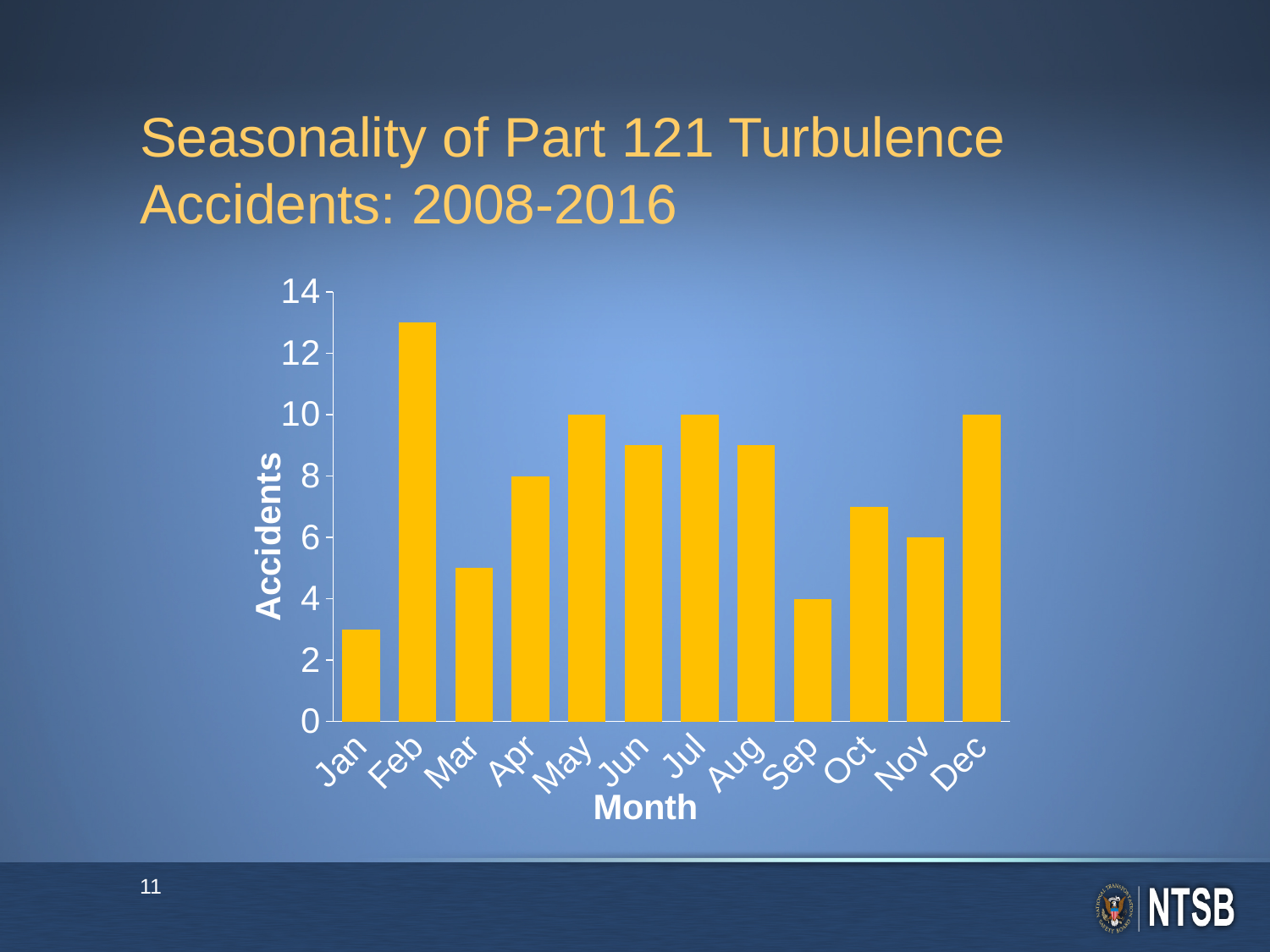
How many accidents are shown for Nov? 6 How many accidents are shown for May? 10 How many months are plotted on the x axis? 12 What type of chart is shown on the slide? bar chart Is the value for Feb greater or less than 12? greater What is the difference in accidents between May and Sep? 6 How many accidents are shown for Sep? 4 Which month has more accidents, Mar or Oct? Oct What is the label on the vertical axis? Accidents Is the value for Jan greater or less than 4? less Which month has the lowest number of accidents? Jan Which month has the highest number of accidents? Feb